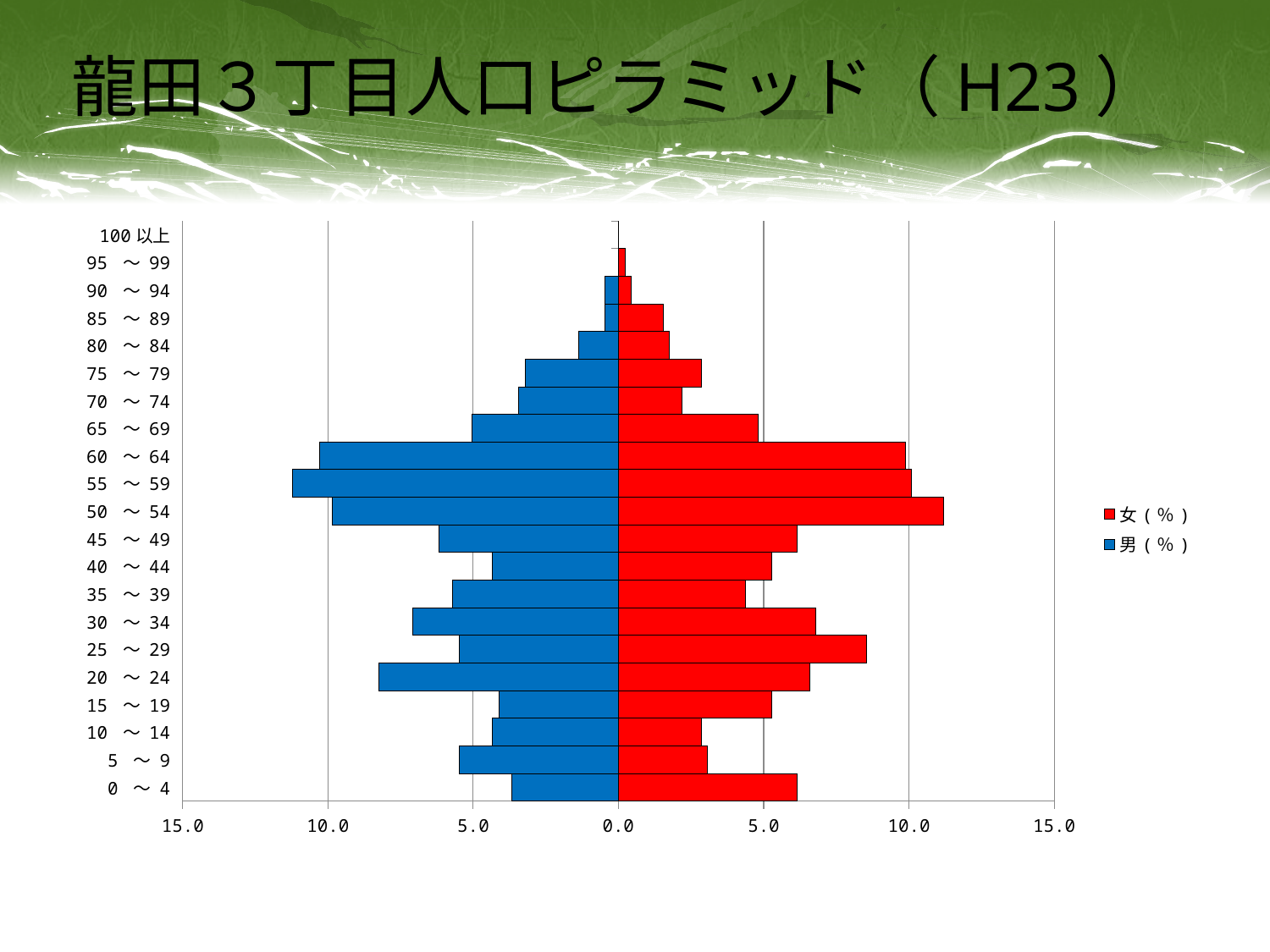
How many series does the legend list? 2 Which age group has the highest value for 女(%)? 50 ～ 54 Is the value for 女(%) in the 25 ～ 29 age group greater or less than 5.0? greater Is the value for 男(%) in the 80 ～ 84 age group greater or less than 5.0? less Is the value for 女(%) in the 50 ～ 54 age group greater or less than 10.0? greater Which age group has the highest value for 男(%)? 55 ～ 59 In the 20 ～ 24 age group, which is larger, 男(%) or 女(%)? 男(%) What kind of chart is shown on the slide? bar chart How many age categories are shown on the vertical axis? 21 In the 0 ～ 4 age group, which is larger, 男(%) or 女(%)? 女(%) What colour represents 女(%) in the chart? red